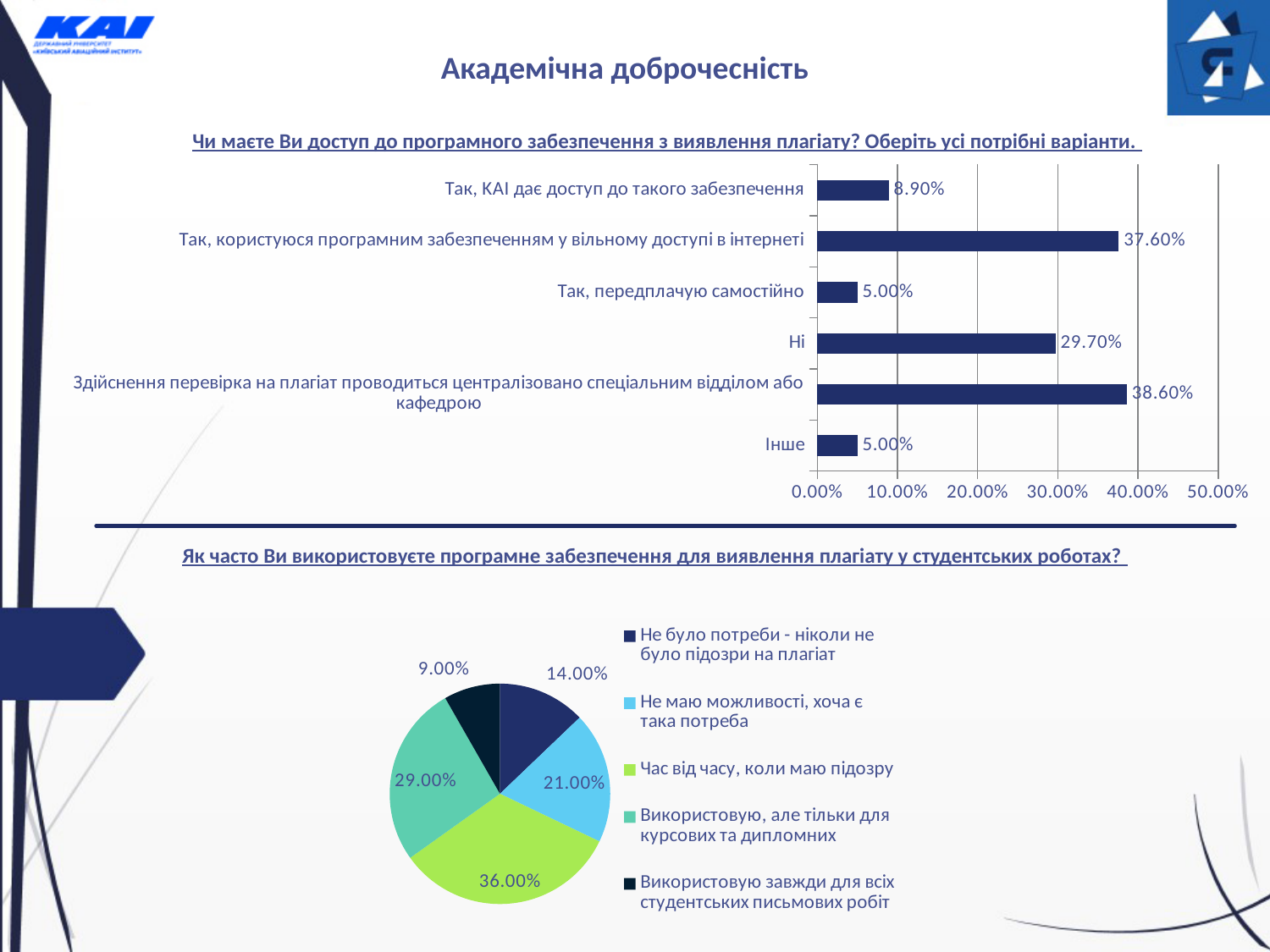
What type of chart is the top chart on the slide? Bar chart In the top bar chart, how many categories are shown? 6 In the top bar chart, which is larger: "Так, КАІ дає доступ до такого забезпечення" or "Так, передплачую самостійно"? Так, КАІ дає доступ до такого забезпечення In the top bar chart, what is the value for "Ні"? 29.70% In the bottom pie chart, what share does "Час від часу, коли маю підозру" have? 36.00% In the bottom pie chart, what is the value for "Використовую завжди для всіх студентських письмових робіт"? 9.00% In the top bar chart, which category has the highest value? Здійснення перевірка на плагіат проводиться централізовано спеціальним відділом або кафедрою In the top bar chart, what is the difference between "Так, користуюся програмним забезпеченням у вільному доступі в інтернеті" and "Ні"? 7.90% In the bottom pie chart, what is the difference between "Використовую, але тільки для курсових та дипломних" and "Не маю можливості, хоча є така потреба"? 8.00% In the bottom pie chart, how many slices are there? 5 In the top bar chart, what is the value for "Так, КАІ дає доступ до такого забезпечення"? 8.90% In the bottom pie chart, which category has the smallest slice? Використовую завжди для всіх студентських письмових робіт